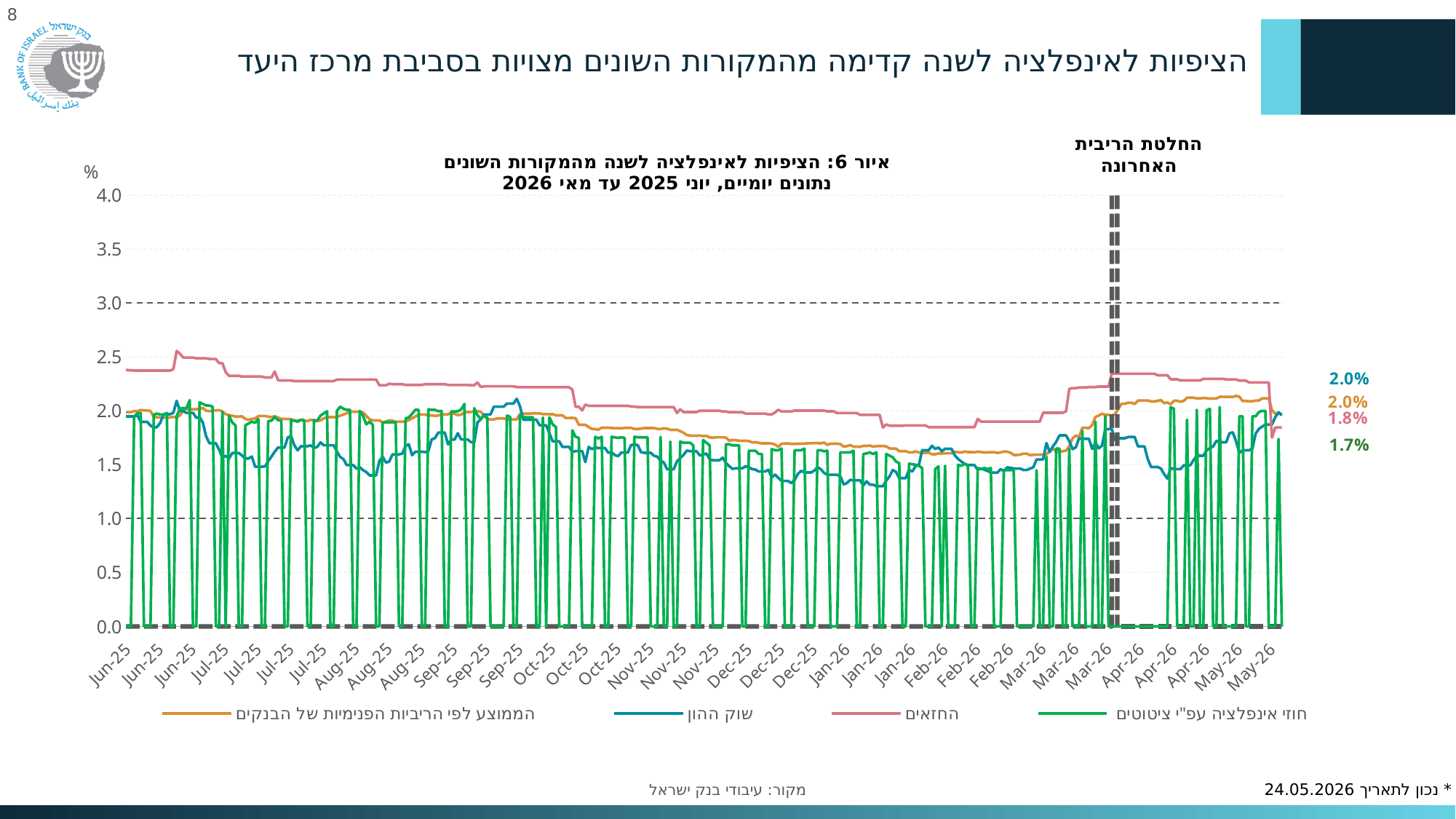
What is the latest value shown for the שוק ההון series? 2.0% How many series does the legend list? 4 What is the latest value shown for the החזאים series? 1.8% What is the latest value shown for the הממוצע לפי הריביות הפנימיות של הבנקים series? 2.0% Which has the higher latest value: החזאים or חוזי אינפלציה עפ"י ציטוטים? החזאים What is the latest value shown for the חוזי אינפלציה עפ"י ציטוטים series? 1.7% Is the value of the החזאים series at the start of the chart (Jun-25) greater or less than 2.0? greater What event does the dashed vertical line near Mar-26 mark? החלטת הריבית האחרונה Which series has the highest value at the start of the chart (Jun-25)? החזאים Does the החזאים series rise or fall between Jun-25 and Feb-26? Fall What kind of chart is shown on the slide? Line chart What is the difference between the latest values of שוק ההון and חוזי אינפלציה עפ"י ציטוטים? 0.3%